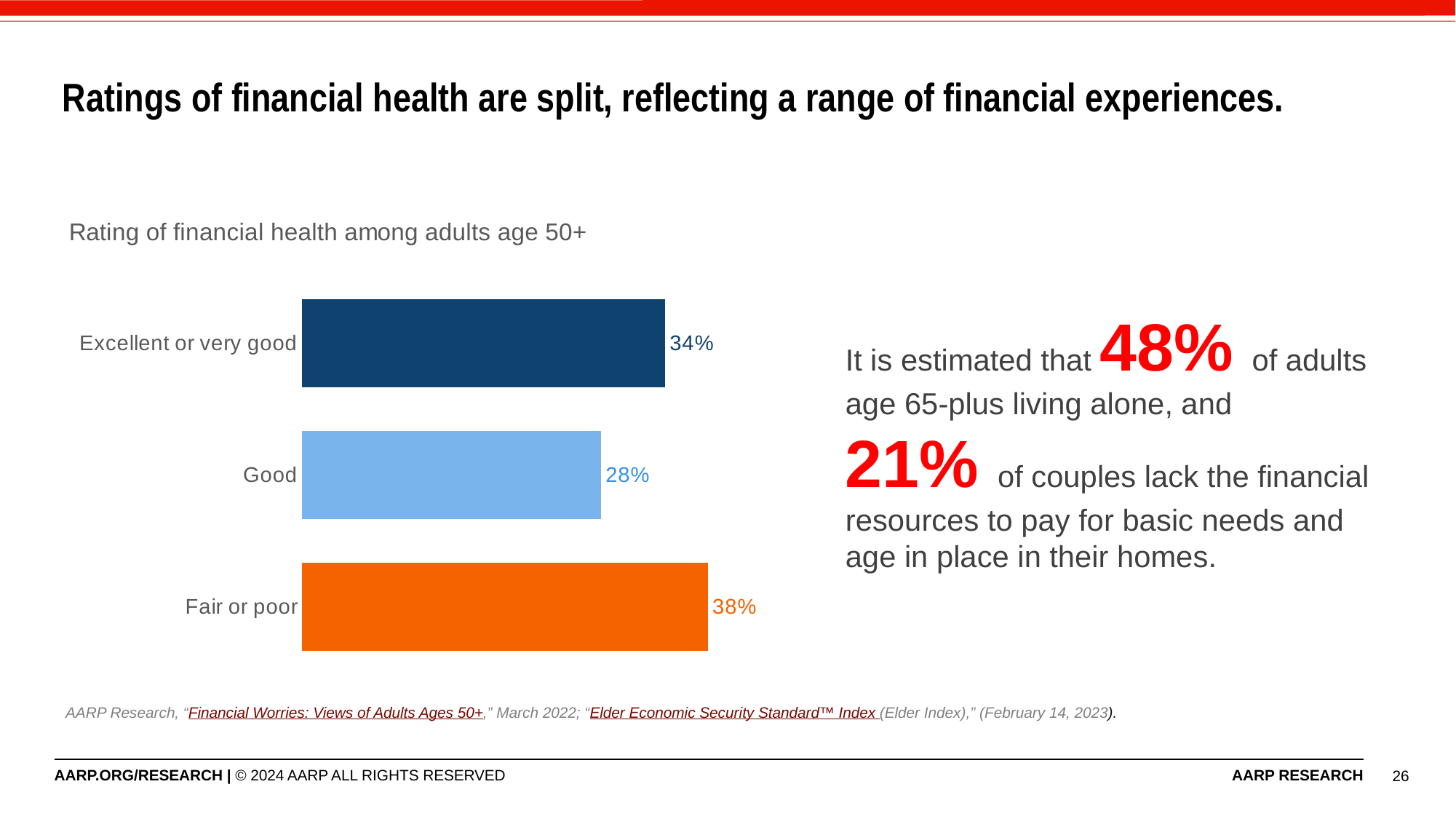
How many rating categories are shown in the chart? 3 What percentage of adults age 50+ rate their financial health as good? 28% What is the title of the chart? Rating of financial health among adults age 50+ What percentage of adults age 50+ rate their financial health as excellent or very good? 34% What is the difference in percentage points between 'Fair or poor' and 'Excellent or very good'? 4 What percentage of adults age 50+ rate their financial health as fair or poor? 38% Which rating category has the lowest percentage? Good Which is larger, the percentage for 'Excellent or very good' or for 'Good'? Excellent or very good What is the difference in percentage points between the 'Fair or poor' and 'Good' categories? 10 Which rating category has the highest percentage? Fair or poor What type of chart is used to show the ratings of financial health? Bar chart What colour is the bar for 'Fair or poor'? Orange